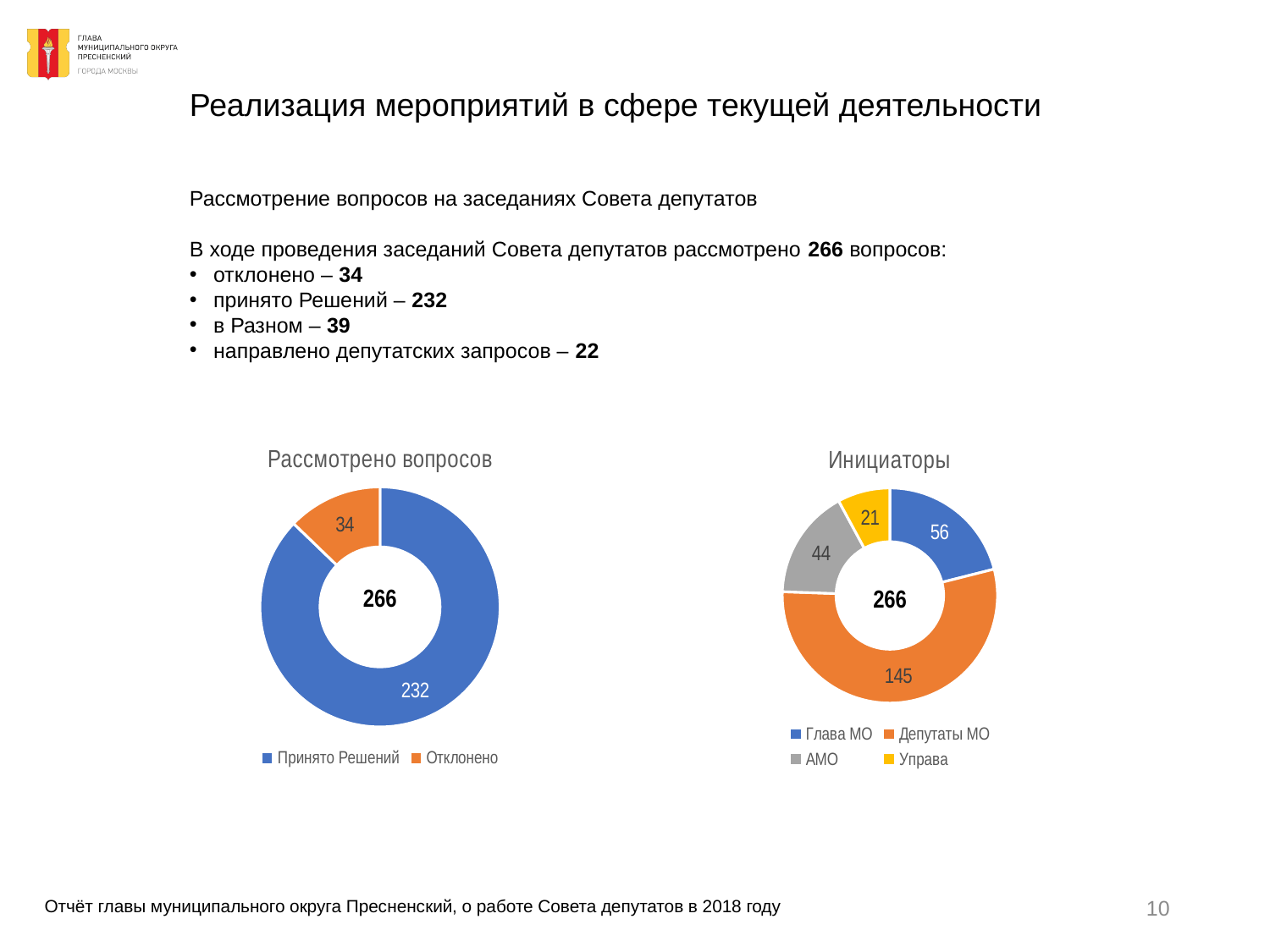
In the chart titled "Инициаторы", which category has the lowest value? Управа In the chart titled "Инициаторы", which is larger: "Глава МО" or "АМО"? Глава МО In the chart titled "Рассмотрено вопросов", what total is shown in the centre of the donut? 266 In the chart titled "Инициаторы", what is the value for "Управа"? 21 In the chart titled "Рассмотрено вопросов", what is the value for "Отклонено"? 34 In the chart titled "Рассмотрено вопросов", what is the value for "Принято Решений"? 232 In the chart titled "Инициаторы", what is the value for "Депутаты МО"? 145 How many categories does the legend of the chart titled "Инициаторы" list? 4 In the chart titled "Рассмотрено вопросов", what is the difference between "Принято Решений" and "Отклонено"? 198 What type of chart is the chart titled "Рассмотрено вопросов"? Donut (pie) chart In the chart titled "Инициаторы", what is the difference between "Глава МО" and "АМО"? 12 In the chart titled "Инициаторы", which category has the highest value? Депутаты МО